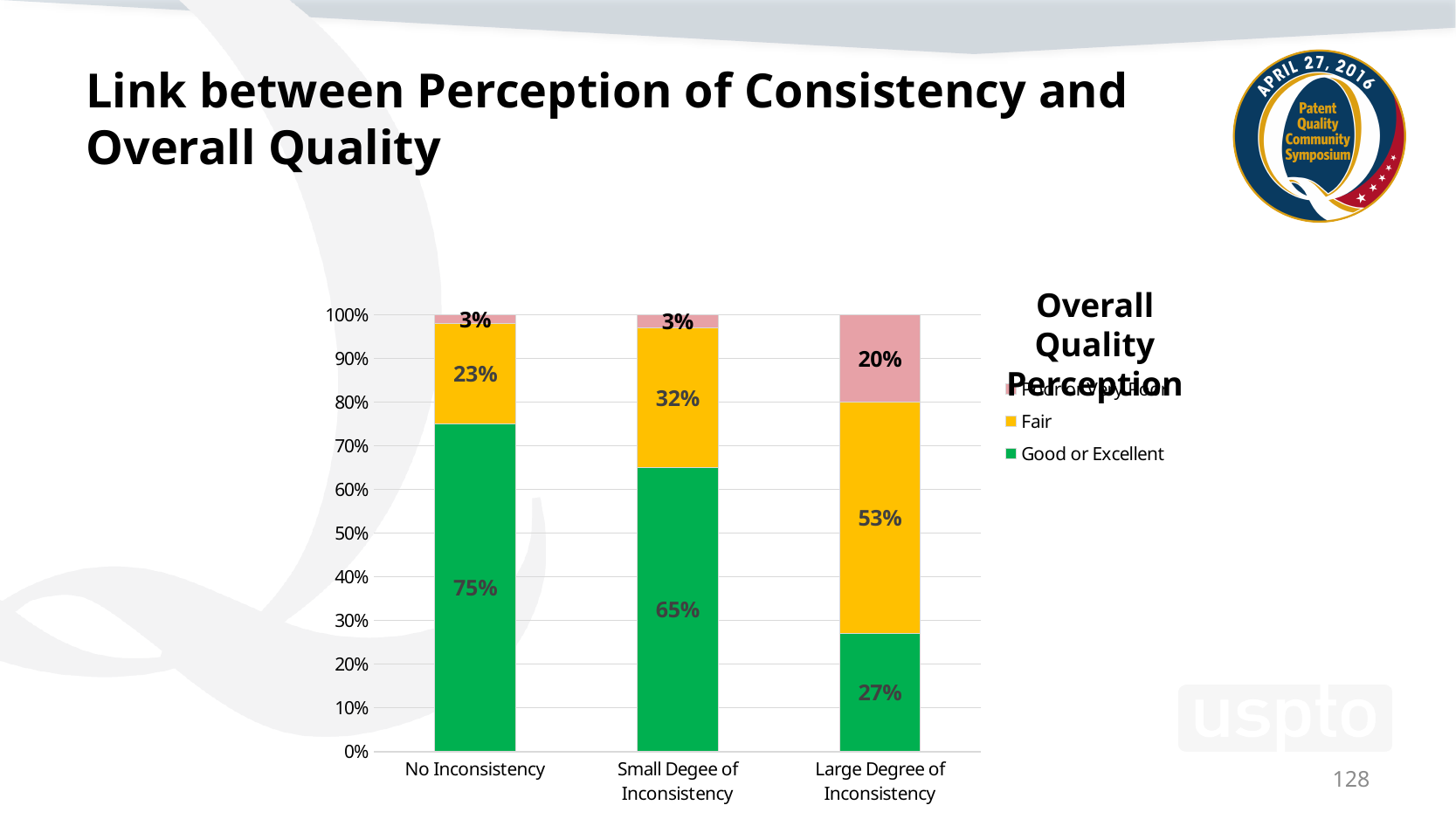
How many categories are shown on the x axis of the chart? 3 Which category has the lowest Good or Excellent value? Large Degree of Inconsistency What is the value of the top (pink) segment for Large Degree of Inconsistency? 20% What is the Good or Excellent value for No Inconsistency? 75% How does the Good or Excellent value change as the degree of inconsistency increases along the x axis? It falls How many series does the chart's legend list? 3 What is the Fair value for Small Degee of Inconsistency? 32% What kind of chart is shown on the slide? Stacked bar chart What is the difference between the Good or Excellent values for No Inconsistency and Small Degee of Inconsistency? 10% What is the Good or Excellent value for Large Degree of Inconsistency? 27% Which is larger: the Fair value for No Inconsistency or the Fair value for Small Degee of Inconsistency? Small Degee of Inconsistency Which category has the highest Fair value? Large Degree of Inconsistency